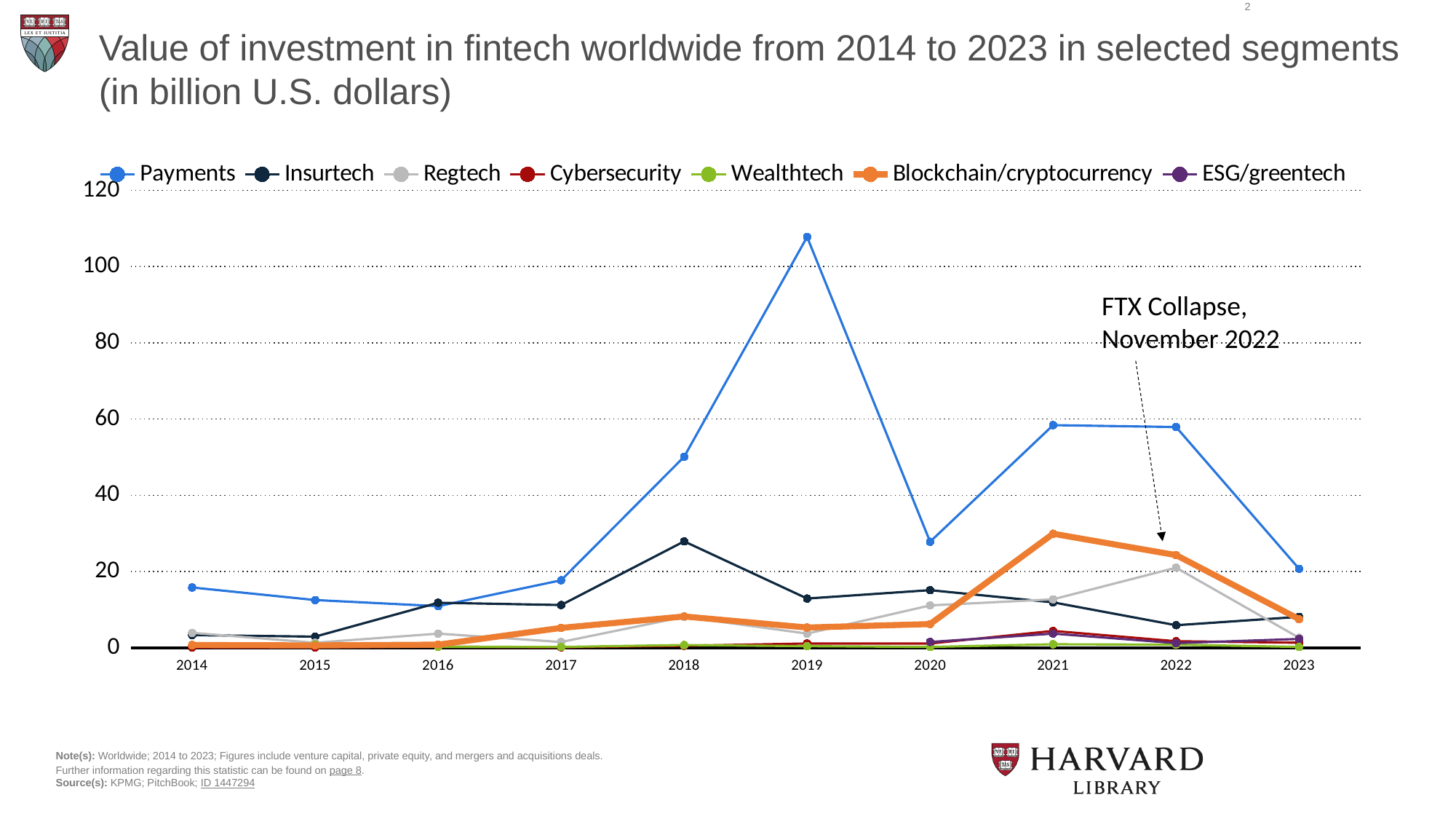
How many years are plotted along the x axis? 10 Does the Payments series rise or fall from 2021 to 2023? fall Is the value for Payments in 2023 greater or less than 40? less What event does the annotation with the dashed arrow on the chart refer to? FTX Collapse, November 2022 In which year does the Payments series reach its highest value? 2019 Is the value for Payments in 2019 greater or less than 100? greater In 2018, which is larger: Payments or Insurtech? Payments How many series does the legend list? 7 In which year does the Blockchain/cryptocurrency series reach its highest value? 2021 What type of chart is shown on the slide? line chart Is the value for Blockchain/cryptocurrency in 2021 greater or less than 20? greater In 2022, which is larger: Regtech or Insurtech? Regtech